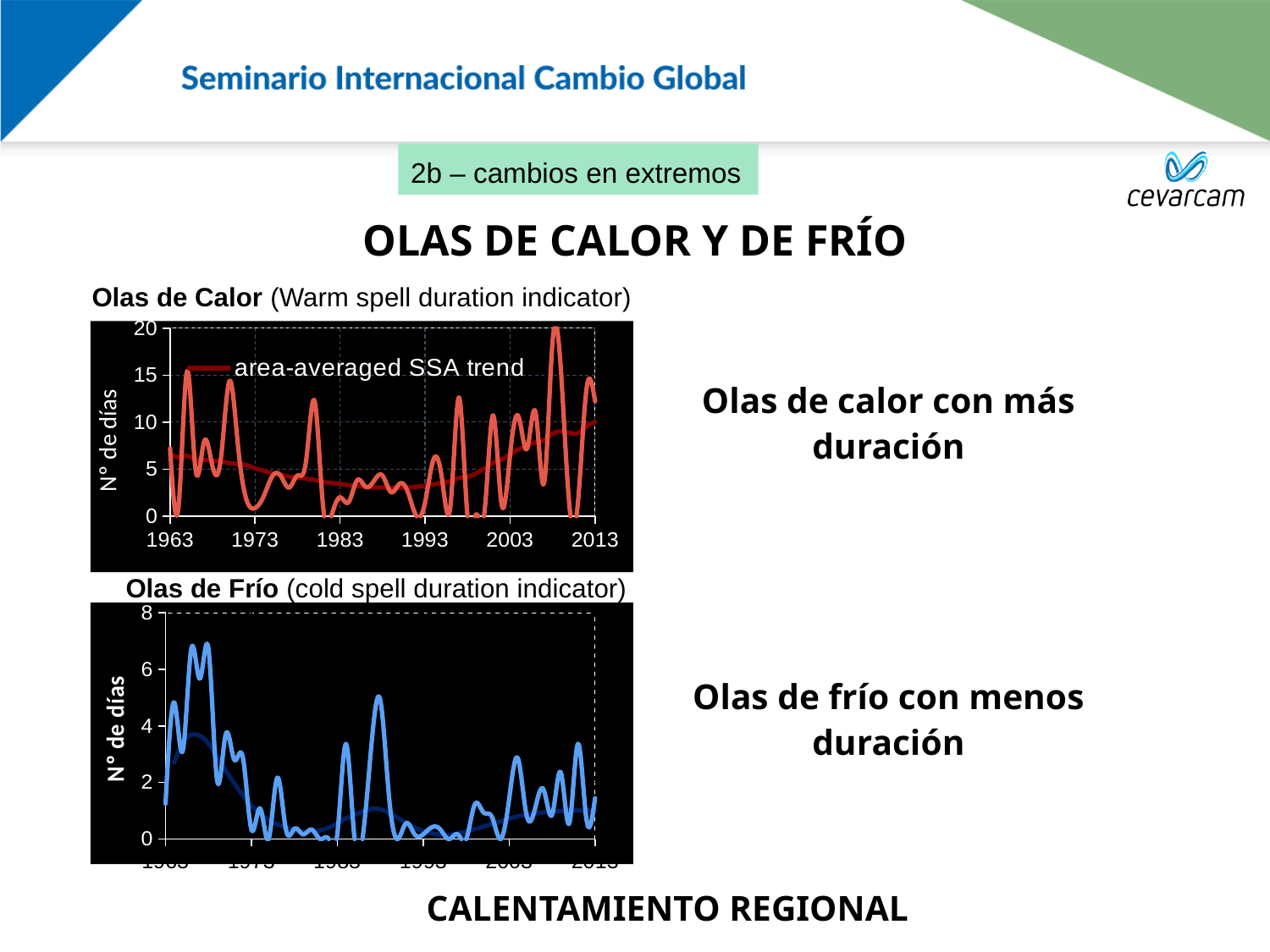
In the 'Olas de Calor' chart, does the smoothed trend line end higher or lower in 2013 than it started in 1963? higher In the 'Olas de Calor' chart, is the highest peak of the red line (around 2008) greater or less than 15? greater In the 'Olas de Frío' chart, is the peak of the blue line around 1990 greater or less than 4? greater In the 'Olas de Calor' chart, is the value of the smoothed trend line in 2013 greater or less than 5? greater What is the first year shown on the x axis of the 'Olas de Calor' chart? 1963 What kind of chart is the 'Olas de Calor' chart at the top of the slide? line chart What kind of chart is the 'Olas de Frío' chart at the bottom of the slide? line chart In the 'Olas de Frío' chart, does the smoothed trend line fall or rise from 1963 to 2013? fall In the 'Olas de Calor' chart, what is the label of the y axis? N° de días In the 'Olas de Calor' chart, what entry does the legend show? area-averaged SSA trend How many charts are shown on the slide? 2